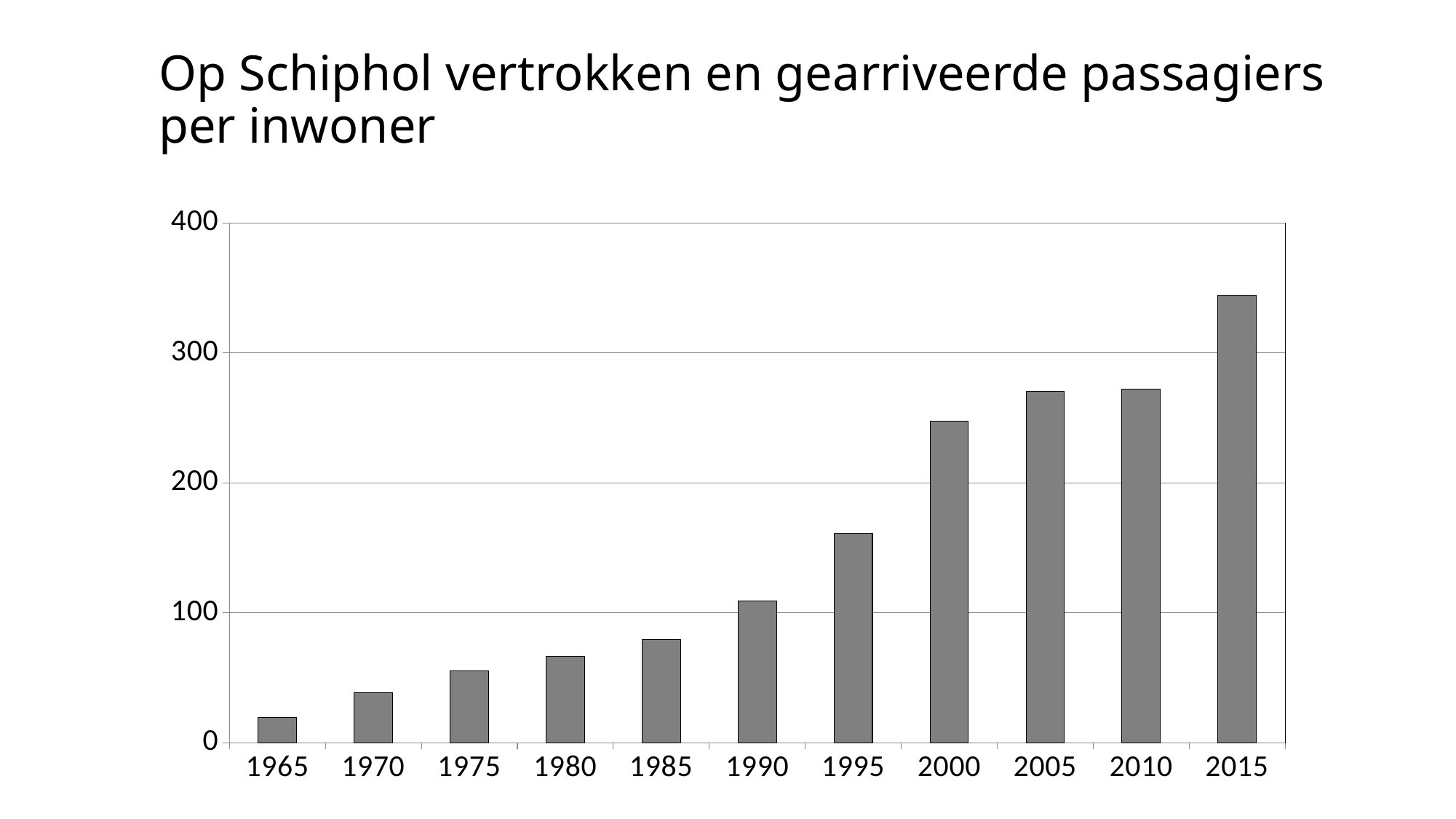
Do the values rise or fall from 1965 to 2015? rise Which year has the lowest value? 1965 Which is larger, the value for 1975 or the value for 1990? 1990 Is the value for 1985 greater or less than 100? less Which year has the highest value? 2015 What is the title of the chart? Op Schiphol vertrokken en gearriveerde passagiers per inwoner Which is larger, the value for 1995 or the value for 2000? 2000 Is the value for 1995 greater or less than 200? less Is the value for 2000 greater or less than 200? greater What kind of chart is shown on the slide? bar chart How many years are shown on the x axis? 11